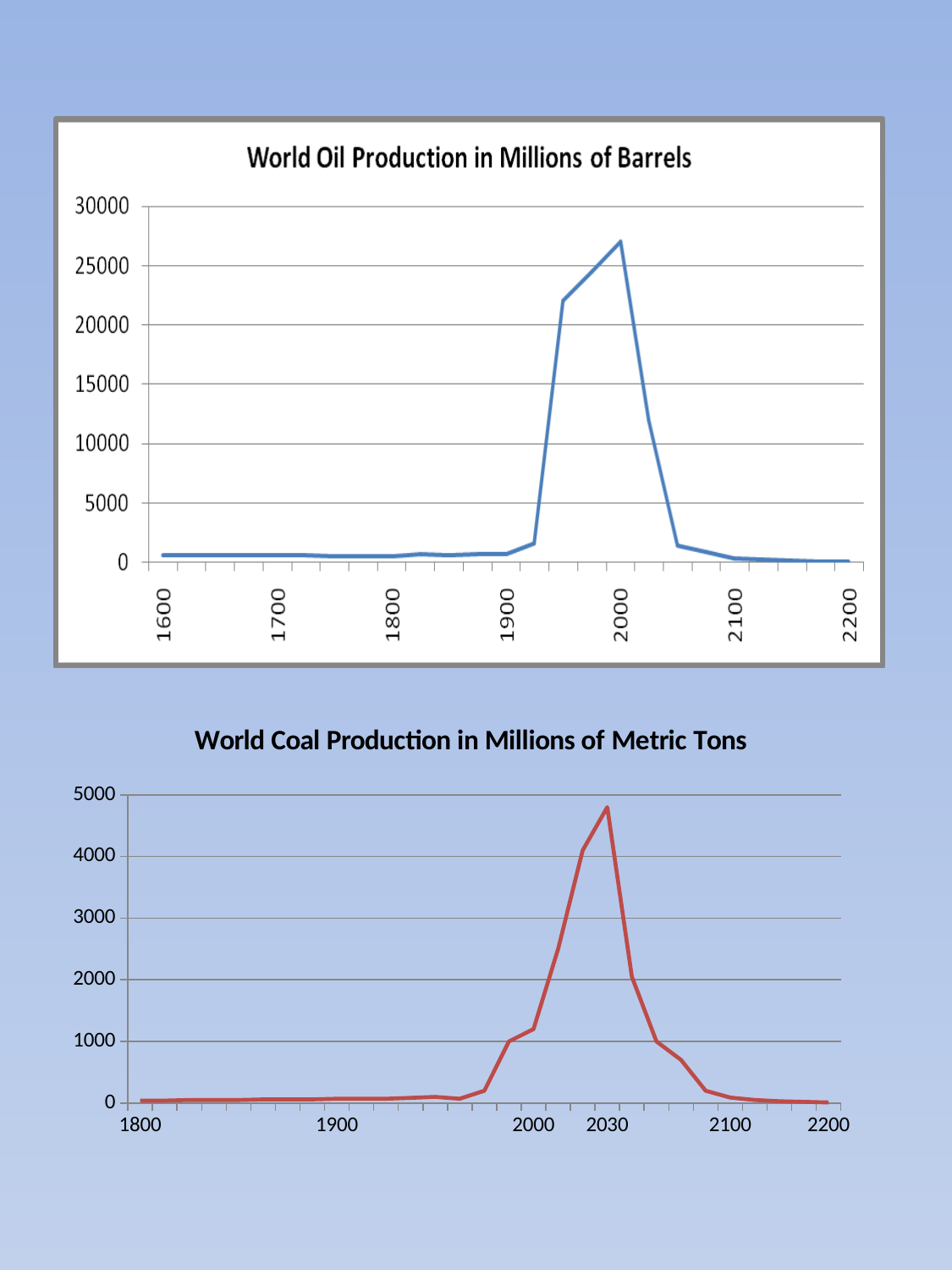
In the 'World Oil Production in Millions of Barrels' chart, is the value at 2000 greater or less than 20000? greater In the 'World Oil Production in Millions of Barrels' chart, is the value at 1900 greater or less than 5000? less In the 'World Coal Production in Millions of Metric Tons' chart, do the values rise or fall between 2030 and 2200? fall In the 'World Oil Production in Millions of Barrels' chart, do the values rise or fall between 2000 and 2200? fall In the 'World Coal Production in Millions of Metric Tons' chart, is the value at 1900 greater or less than 1000? less What colour is the line in the 'World Coal Production in Millions of Metric Tons' chart? red In the 'World Coal Production in Millions of Metric Tons' chart, at which labelled year does the line reach its highest value? 2030 What kind of chart is the 'World Oil Production in Millions of Barrels' chart? line chart What kind of chart is the 'World Coal Production in Millions of Metric Tons' chart? line chart